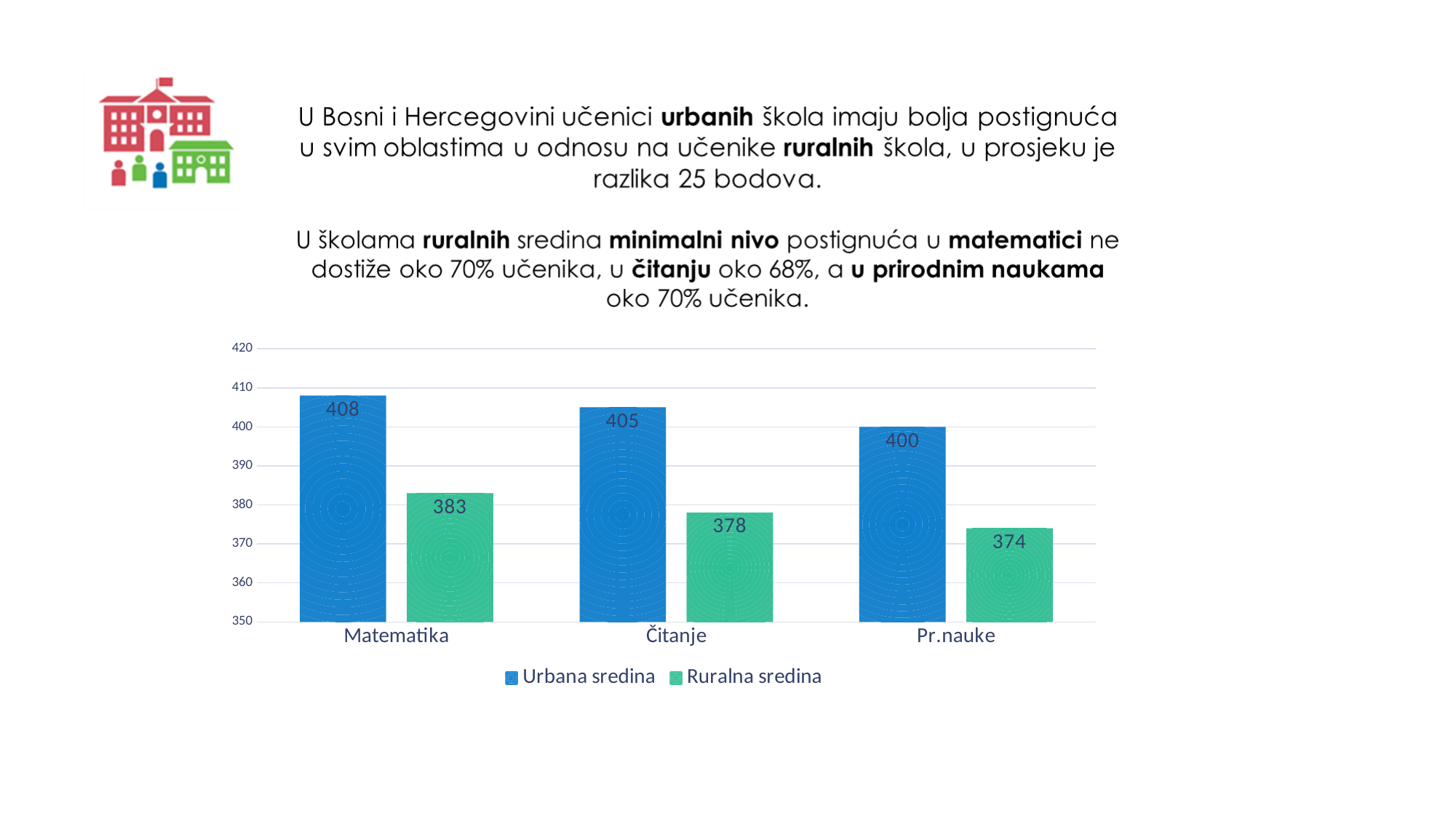
What is the value for Ruralna sredina in Čitanje? 378 How many series does the legend list? 2 Which is larger: Ruralna sredina in Matematika or Urbana sredina in Pr.nauke? Urbana sredina in Pr.nauke Do the Ruralna sredina values rise or fall from Matematika to Pr.nauke? Fall Which category has the highest value for Urbana sredina? Matematika What kind of chart is shown on the slide? Bar chart What is the difference between Urbana sredina and Ruralna sredina in Matematika? 25 What is the value for Urbana sredina in Matematika? 408 How many categories are shown on the x axis? 3 What is the value for Ruralna sredina in Pr.nauke? 374 What is the difference between Urbana sredina and Ruralna sredina in Pr.nauke? 26 Which category has the lowest value for Ruralna sredina? Pr.nauke